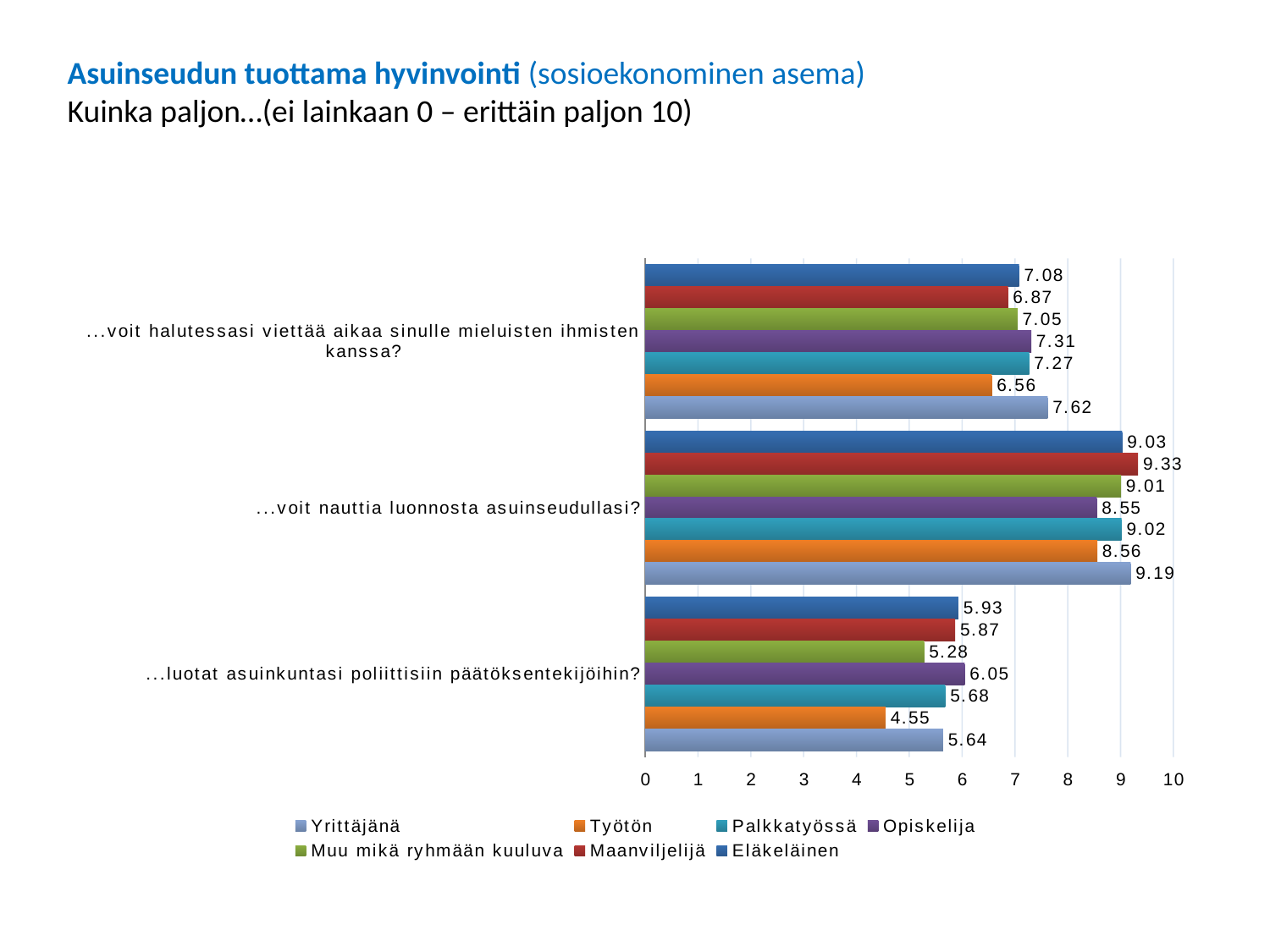
Is the value for Eläkeläinen for '...voit nauttia luonnosta asuinseudullasi?' greater or less than 8? greater Which series has the highest value for '...voit nauttia luonnosta asuinseudullasi?' Maanviljelijä Which series is shown in orange in the legend? Työtön What is the value for Maanviljelijä for '...voit nauttia luonnosta asuinseudullasi?' 9.33 How many question categories are plotted on the chart? 3 What is the value for Yrittäjänä for '...voit halutessasi viettää aikaa sinulle mieluisten ihmisten kanssa?' 7.62 What is the value for Työtön for '...luotat asuinkuntasi poliittisiin päätöksentekijöihin?' 4.55 For '...luotat asuinkuntasi poliittisiin päätöksentekijöihin?', which is larger: Opiskelija or Muu mikä ryhmään kuuluva? Opiskelija Which series has the lowest value for '...luotat asuinkuntasi poliittisiin päätöksentekijöihin?' Työtön What is the difference between the Yrittäjänä and Työtön values for '...voit halutessasi viettää aikaa sinulle mieluisten ihmisten kanssa?' 1.06 How many series does the legend list? 7 What kind of chart is shown on the slide? bar chart